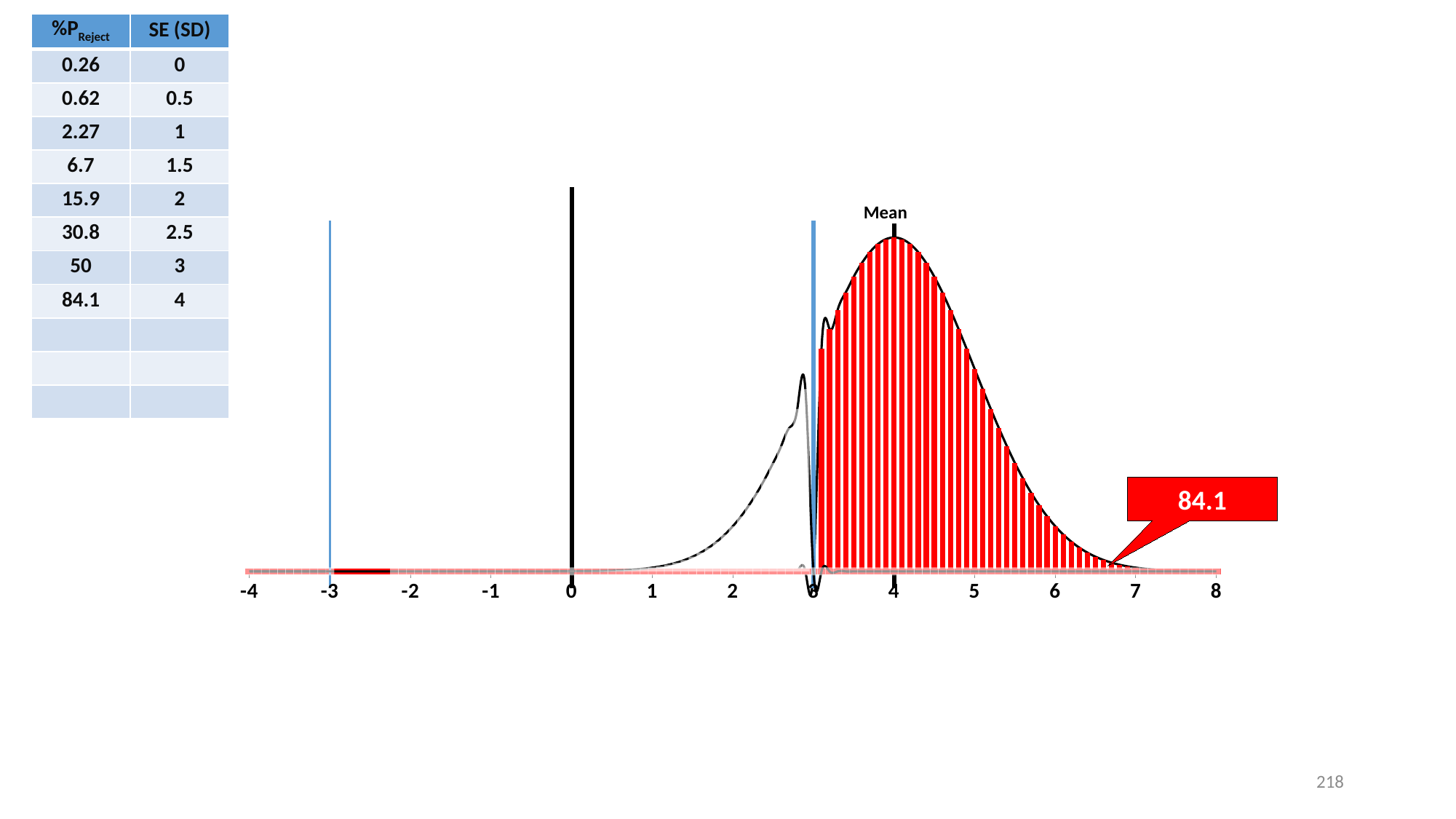
How many tick labels are shown on the chart's x-axis? 13 What is the lowest tick label on the chart's x-axis? -4 What is the highest tick label on the chart's x-axis? 8 At which x-axis value is the tall black vertical line drawn? 0 At which x-axis value is the label "Mean" placed on the chart? 4 Moving along the x axis from the Mean at 4 toward 8, does the curve rise or fall? fall At which x-axis value is the blue vertical line on the left side of the chart drawn? -3 Is the peak of the curve located at an x value greater or less than 2? greater In the table on the slide, what is the SE (SD) value when %P Reject is 50? 3 What value is shown in the red callout box on the chart? 84.1 In the table on the slide, what is the %P Reject value when SE (SD) is 4? 84.1 Is the red shaded area of the chart to the left or to the right of the blue vertical line at 3? right